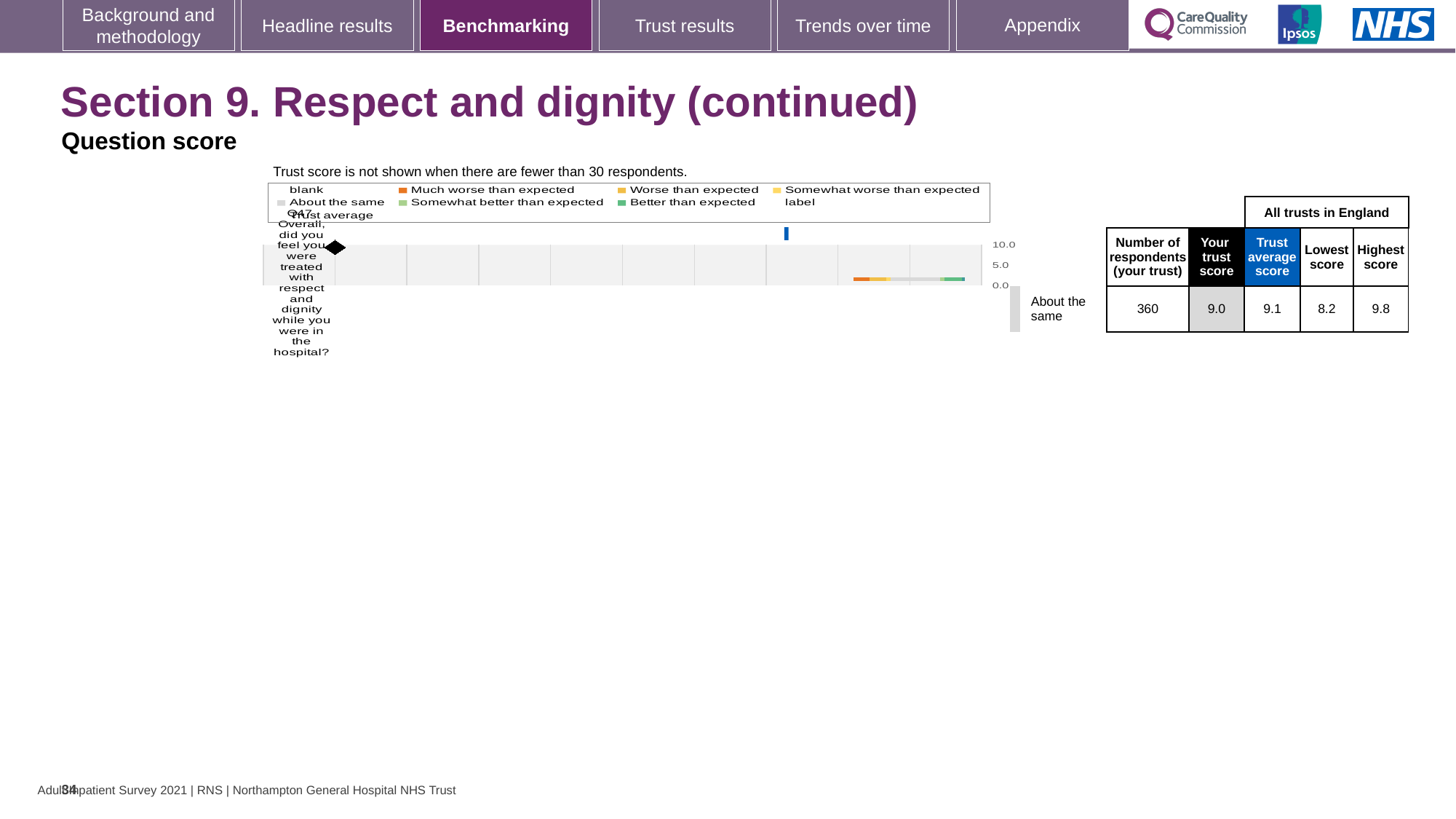
Which is larger for Q47: the trust's own score or the trust average score? Trust average score What is the trust average score for Q47 across all trusts in England? 9.1 What is the highest score among all trusts in England for Q47? 9.8 What kind of chart is used to show the Q47 question score? Bar chart Is the trust score for Q47 greater or less than 5.0? greater What is the difference between the highest and lowest scores for Q47 across all trusts in England? 1.6 How is the trust's result for Q47 categorised relative to expectations? About the same What is the difference between the trust average score and the trust's own score for Q47? 0.1 What is the lowest score among all trusts in England for Q47? 8.2 How many respondents from the trust answered Q47? 360 What is the trust score shown for Q47 (Overall, did you feel you were treated with respect and dignity while you were in the hospital?)? 9.0 What is the highest value shown on the chart's score axis? 10.0